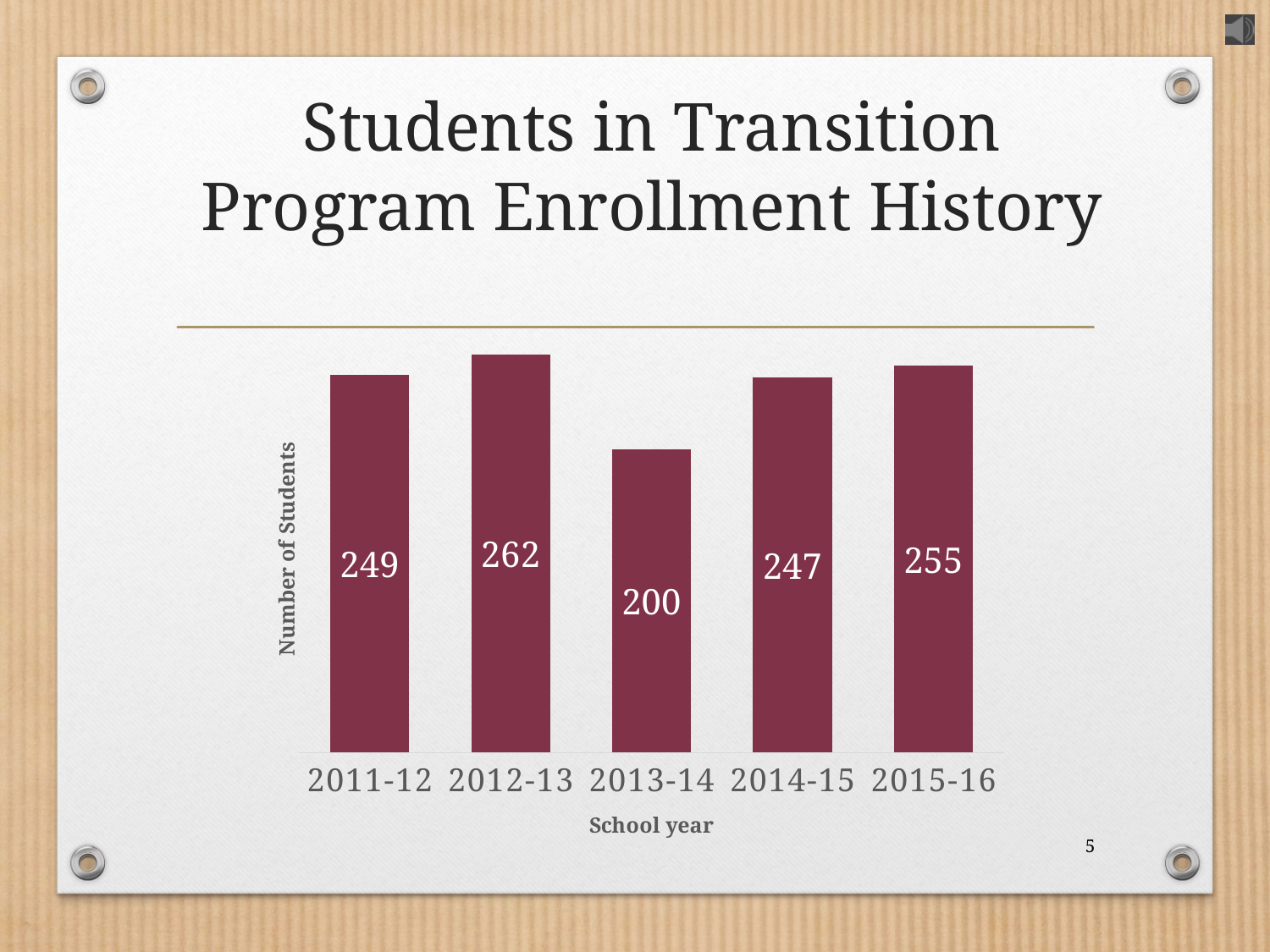
Which had more students, 2011-12 or 2014-15? 2011-12 What is the difference in number of students between 2012-13 and 2013-14? 62 How many students were enrolled in 2013-14? 200 Which school year had the highest number of students? 2012-13 How many school years are shown on the chart? 5 What is the number of students for 2015-16? 255 What kind of chart is shown on the slide? Bar chart Which school year had the lowest number of students? 2013-14 What is the difference in number of students between 2015-16 and 2014-15? 8 What is the number of students for 2011-12? 249 What is the label of the vertical axis? Number of Students Did the number of students rise or fall from 2013-14 to 2014-15? Rise